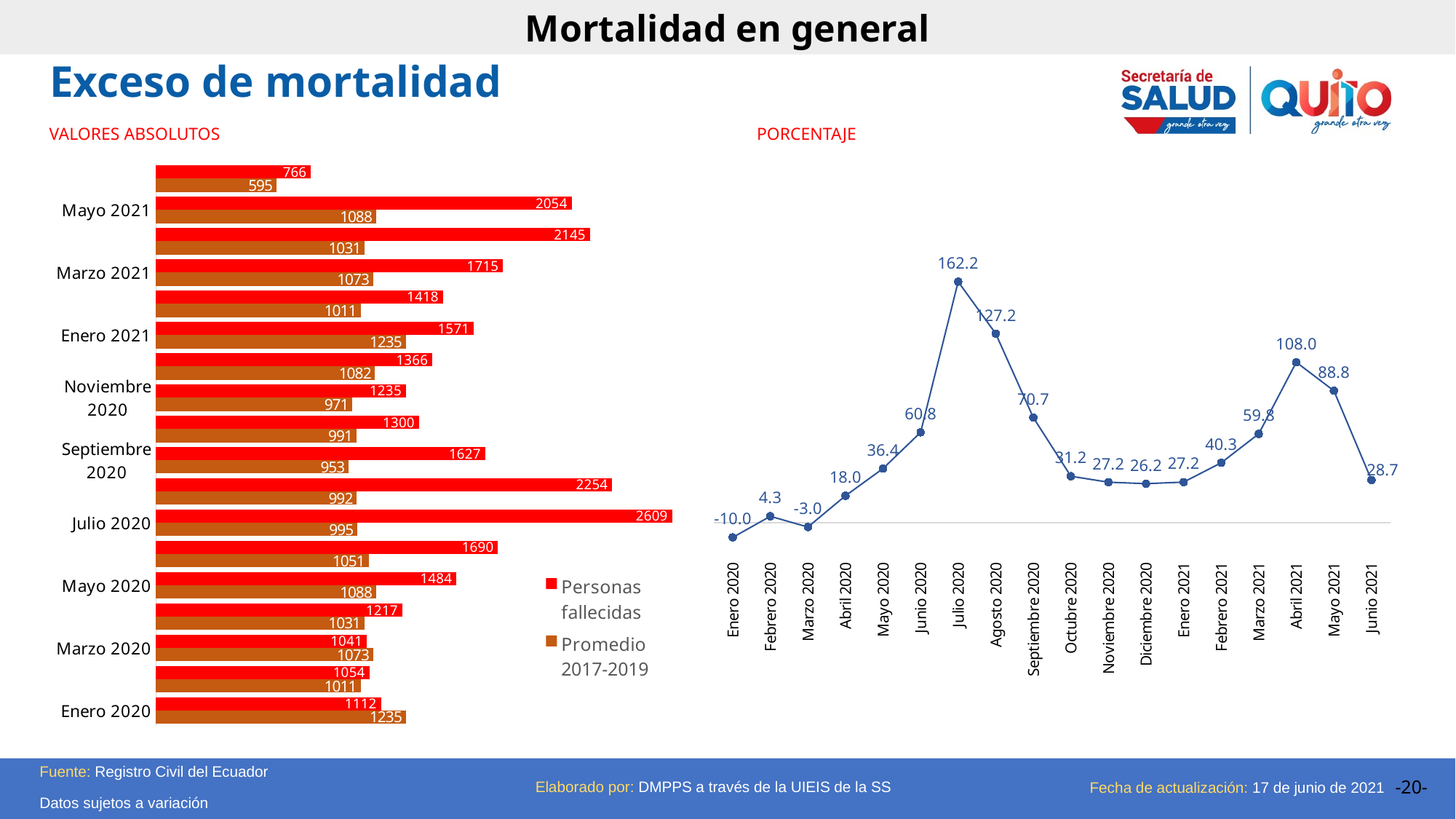
In the VALORES ABSOLUTOS chart, what is the value of Personas fallecidas for Julio 2020? 2609 In the VALORES ABSOLUTOS chart, which labeled month has the highest Personas fallecidas value? Julio 2020 In the PORCENTAJE chart, what is the value for Julio 2020? 162.2 In the VALORES ABSOLUTOS chart, what is the difference between Personas fallecidas and Promedio 2017-2019 for Mayo 2021? 966 In the VALORES ABSOLUTOS chart, which is larger for Enero 2020: Personas fallecidas or Promedio 2017-2019? Promedio 2017-2019 In the PORCENTAJE chart, which month has the lowest value? Enero 2020 In the PORCENTAJE chart, do the values rise or fall from Julio 2020 to Diciembre 2020? Fall In the PORCENTAJE chart, what is the difference between the values for Abril 2021 and Mayo 2021? 19.2 In the VALORES ABSOLUTOS chart, what is the Promedio 2017-2019 value for Enero 2021? 1235 What kind of chart is the VALORES ABSOLUTOS chart? Bar chart How many series does the legend of the VALORES ABSOLUTOS chart list? 2 How many data points are plotted in the PORCENTAJE chart? 18